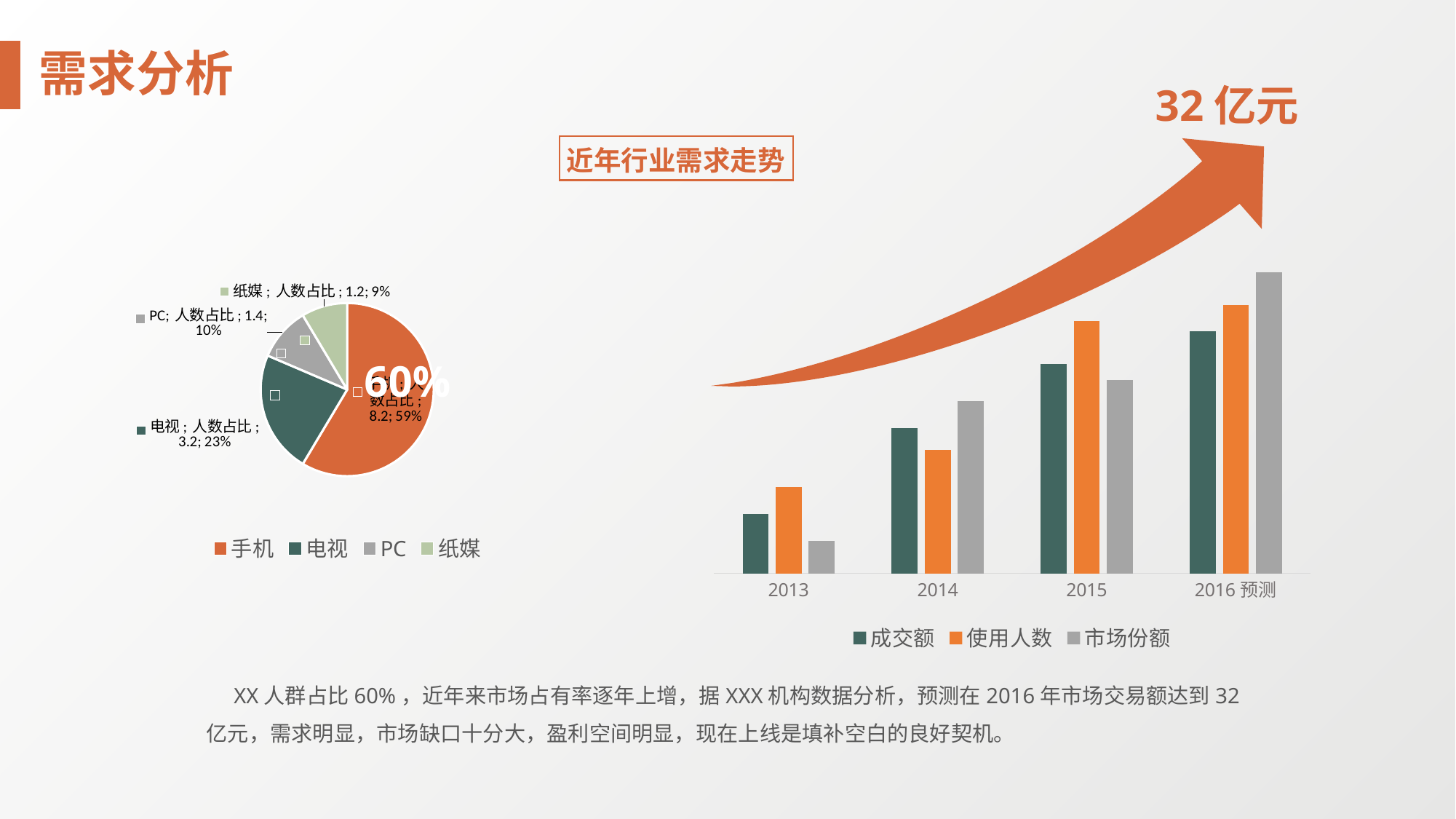
In the pie chart on the left, which category has the smallest slice? 纸媒 In the pie chart on the left, what is the 人数占比 value for PC? 1.4 In the pie chart on the left, which category has the largest slice? 手机 How many categories does the legend of the pie chart on the left list? 4 What kind of chart is the chart on the left of the slide? pie chart In the chart titled 近年行业需求走势, how many year categories are shown on the x axis? 4 In the chart titled 近年行业需求走势, do the 成交额 bars rise or fall from 2013 to 2016 预测? rise In the pie chart on the left, what is the difference between the 人数占比 values of 电视 and PC? 1.8 In the pie chart on the left, what percentage share does 电视 have? 23% What kind of chart is the chart titled 近年行业需求走势? bar chart How many series does the legend of the chart titled 近年行业需求走势 list? 3 In the pie chart on the left, what is the 人数占比 value for 纸媒? 1.2